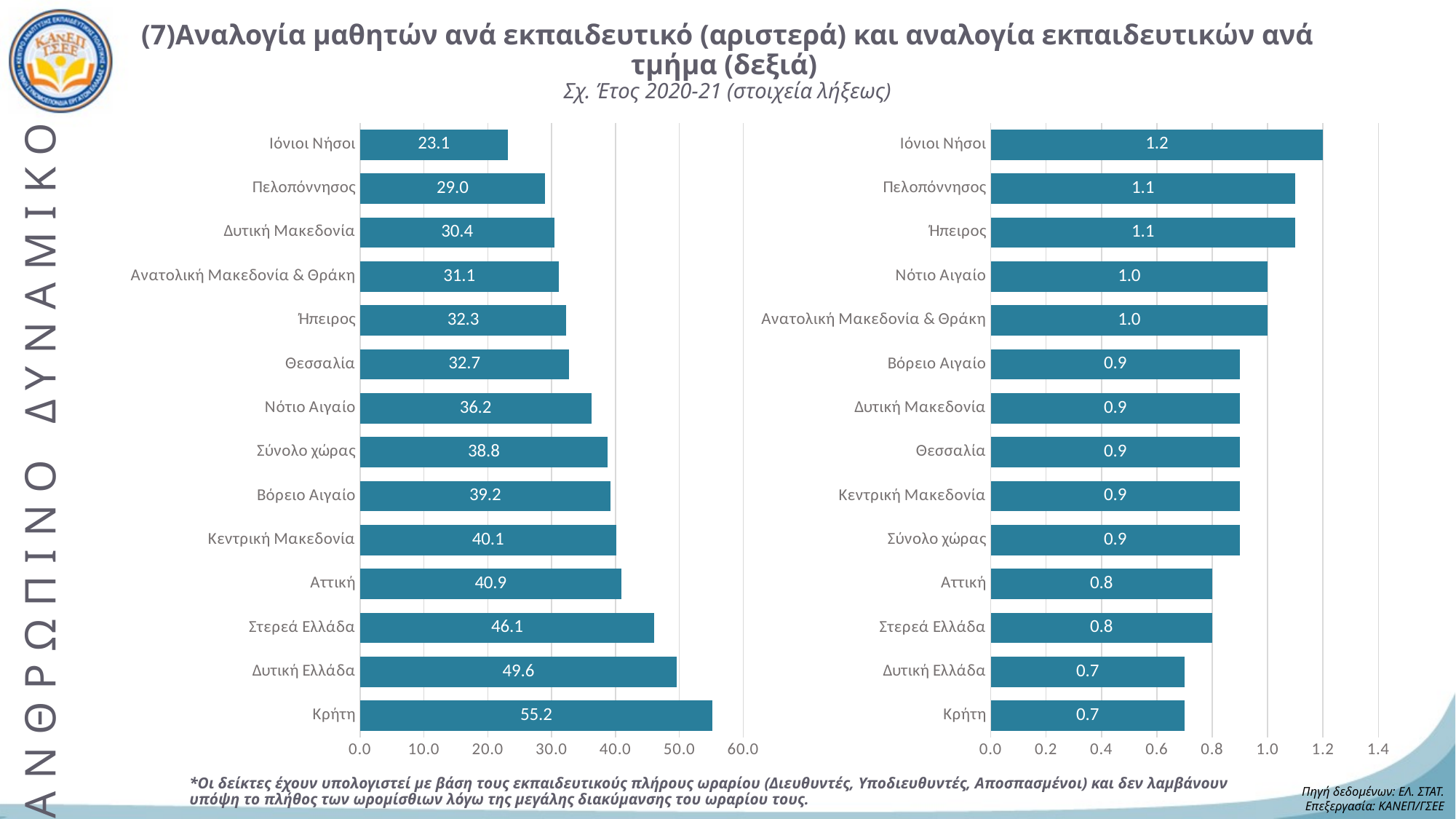
In the left chart (students per teacher), what is the value for Σύνολο χώρας? 38.8 What type of chart is the left chart? Bar chart In the left chart (students per teacher), what is the value for Κρήτη? 55.2 In the right chart (teachers per department), which region has the highest value? Ιόνιοι Νήσοι In the left chart (students per teacher), how many categories are shown? 14 In the right chart (teachers per department), what is the difference between Ιόνιοι Νήσοι and Κρήτη? 0.5 In the right chart (teachers per department), what is the value for Ιόνιοι Νήσοι? 1.2 In the left chart (students per teacher), which is larger, Αττική or Νότιο Αιγαίο? Αττική In the left chart (students per teacher), which region has the highest value? Κρήτη In the right chart (teachers per department), what is the value for Αττική? 0.8 In the left chart (students per teacher), what is the difference between Δυτική Ελλάδα and Στερεά Ελλάδα? 3.5 In the left chart (students per teacher), which region has the lowest value? Ιόνιοι Νήσοι